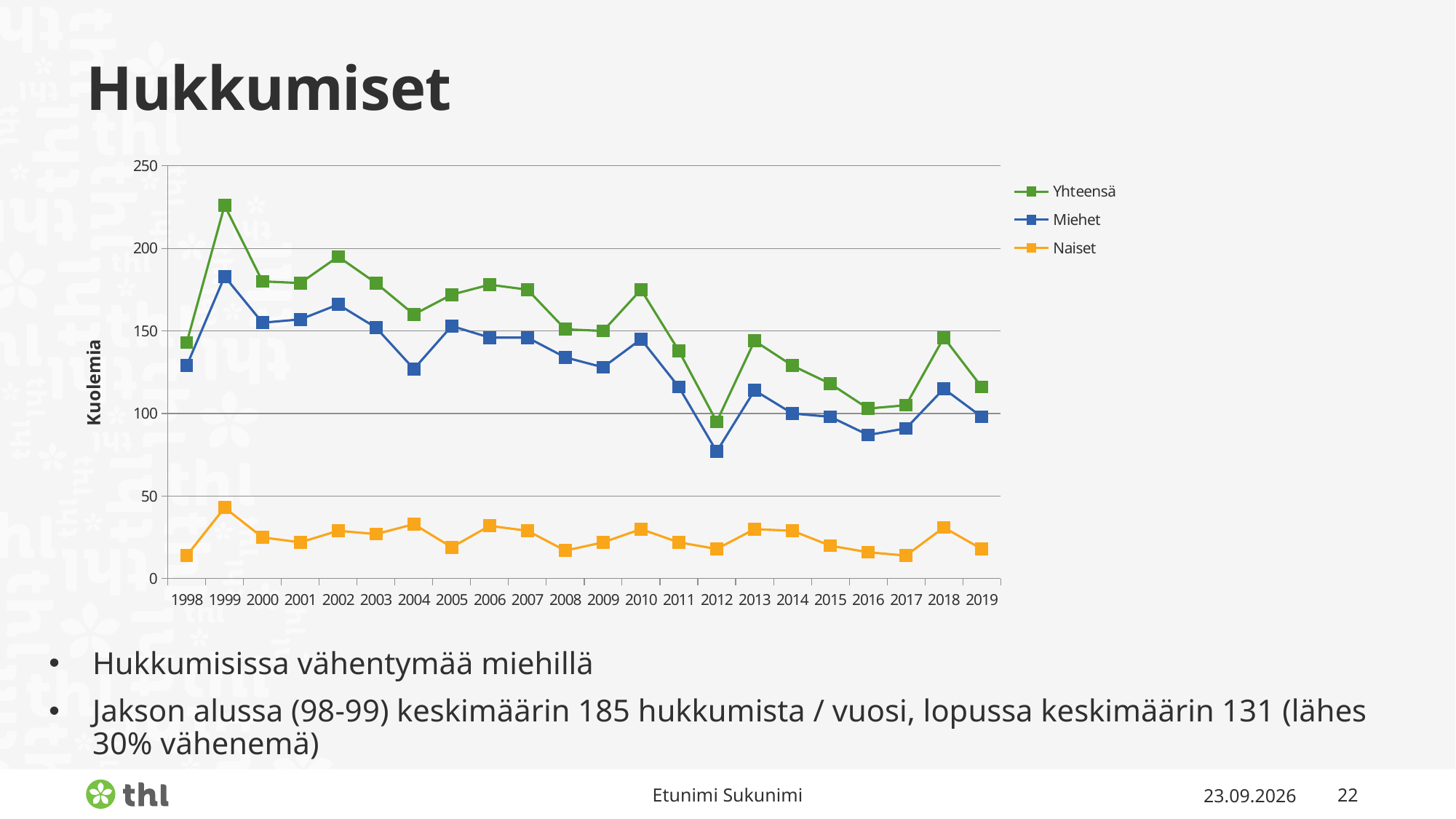
How many years are plotted along the x axis? 22 Which is larger, the Miehet value in 2010 or in 2012? 2010 In which year is the Yhteensä series at its highest? 1999 What kind of chart is shown on the slide? line chart Is the value for Naiset in 1999 greater or less than 50? less Is the value for Miehet in 2012 greater or less than 100? less What is the label on the vertical axis? Kuolemia Is the value for Yhteensä in 1999 greater or less than 200? greater In which year is the Miehet series at its lowest? 2012 In which year is the Naiset series at its highest? 1999 How many series does the legend list? 3 In which year is the Yhteensä series at its lowest? 2012